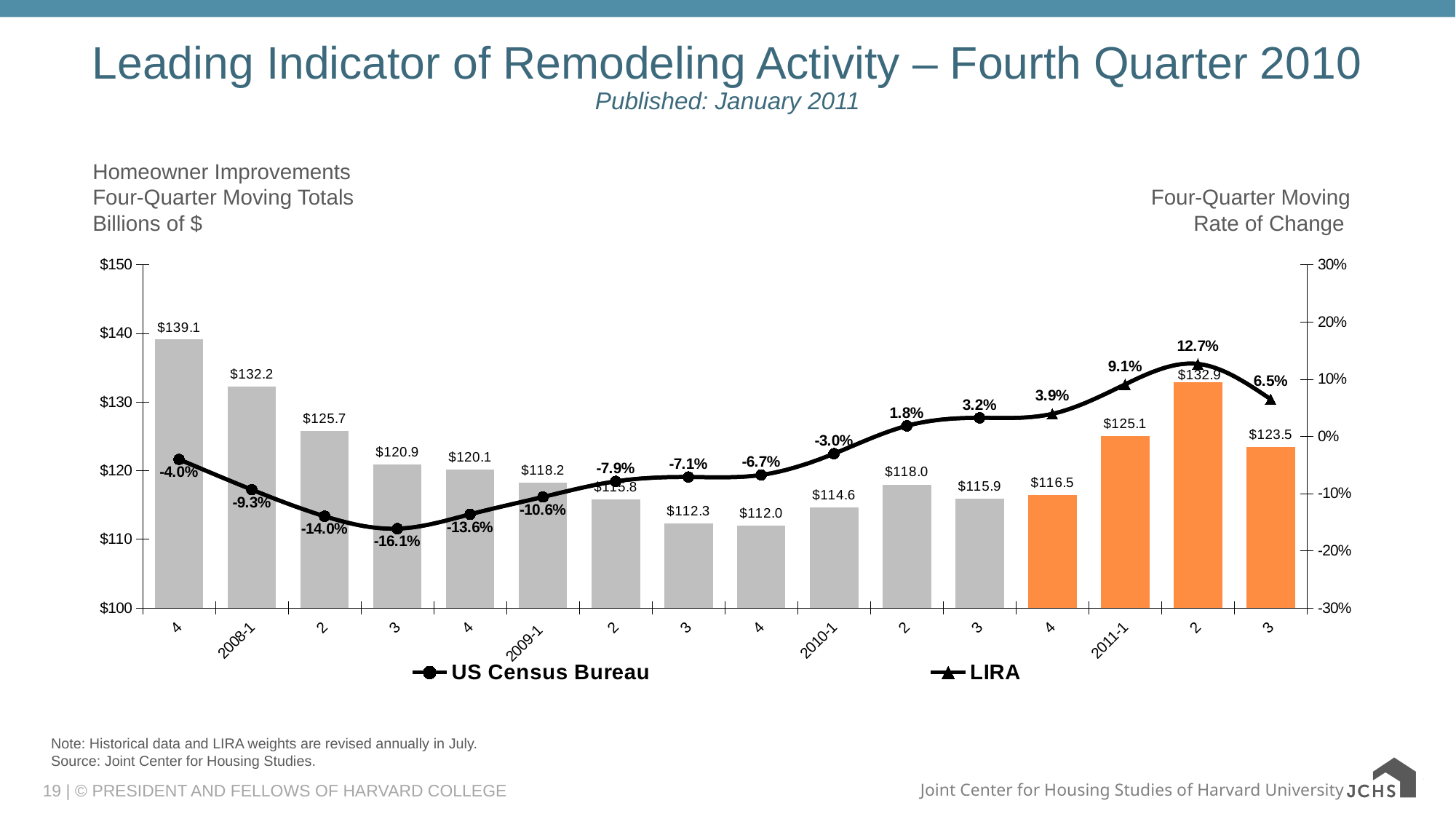
What is the four-quarter moving total of homeowner improvements for 2010-1? $114.6 What is the LIRA rate of change shown for the third quarter of 2011? 6.5% What is the highest four-quarter moving total shown on the chart? $139.1 Which is larger, the four-quarter moving total for 2010-2 or for 2010-3? 2010-2 ($118.0) Do the four-quarter moving totals rise or fall from the first bar through 2009-4? Fall How many quarterly bars are plotted on the chart? 16 What is the four-quarter moving rate of change shown for the third quarter of 2008? -16.1% How many series does the legend list? 2 What kind of chart is shown on the slide? Bar chart with a line What is the difference between the four-quarter moving totals for 2011-2 and 2011-1? $7.8 Which quarter has the lowest four-quarter moving total of homeowner improvements? 2009-4 ($112.0) In which quarter does the rate of change line reach its highest value, and what is it? 2011-2, 12.7%